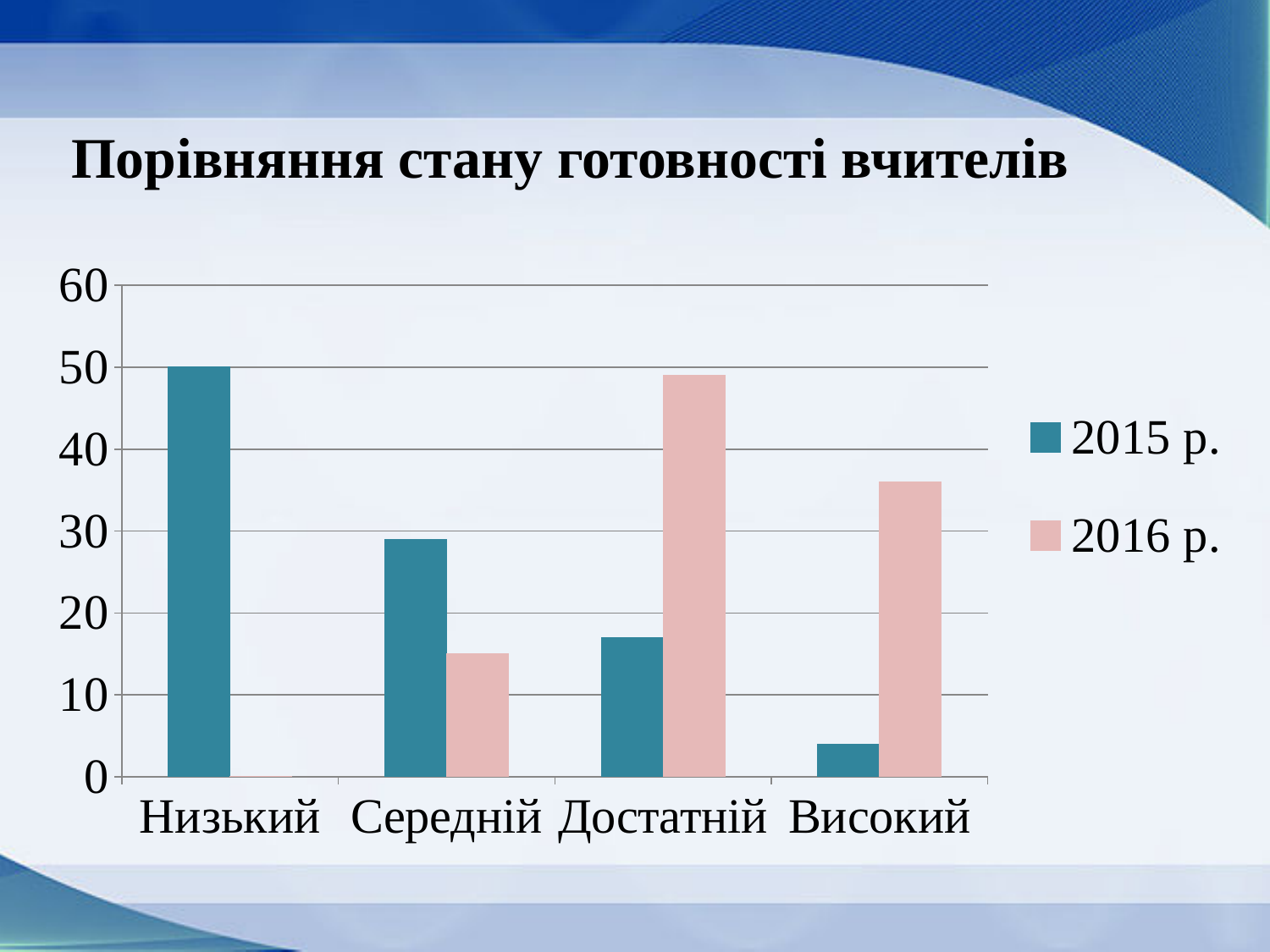
Is the value for Середній in the 2015 р. series greater or less than 20? greater Which category has the lowest value in the 2015 р. series? Високий For Достатній, which series has the larger value, 2015 р. or 2016 р.? 2016 р. Which category has the highest value in the 2016 р. series? Достатній Is the value for Високий in the 2015 р. series greater or less than 10? less What type of chart is shown on the slide? bar chart Is the value for Достатній in the 2016 р. series greater or less than 40? greater How many categories are shown on the x axis? 4 Which category has the highest value in the 2015 р. series? Низький How many series does the legend list? 2 What is the value for Низький in the 2015 р. series? 50 What is the title of the chart? Порівняння стану готовності вчителів